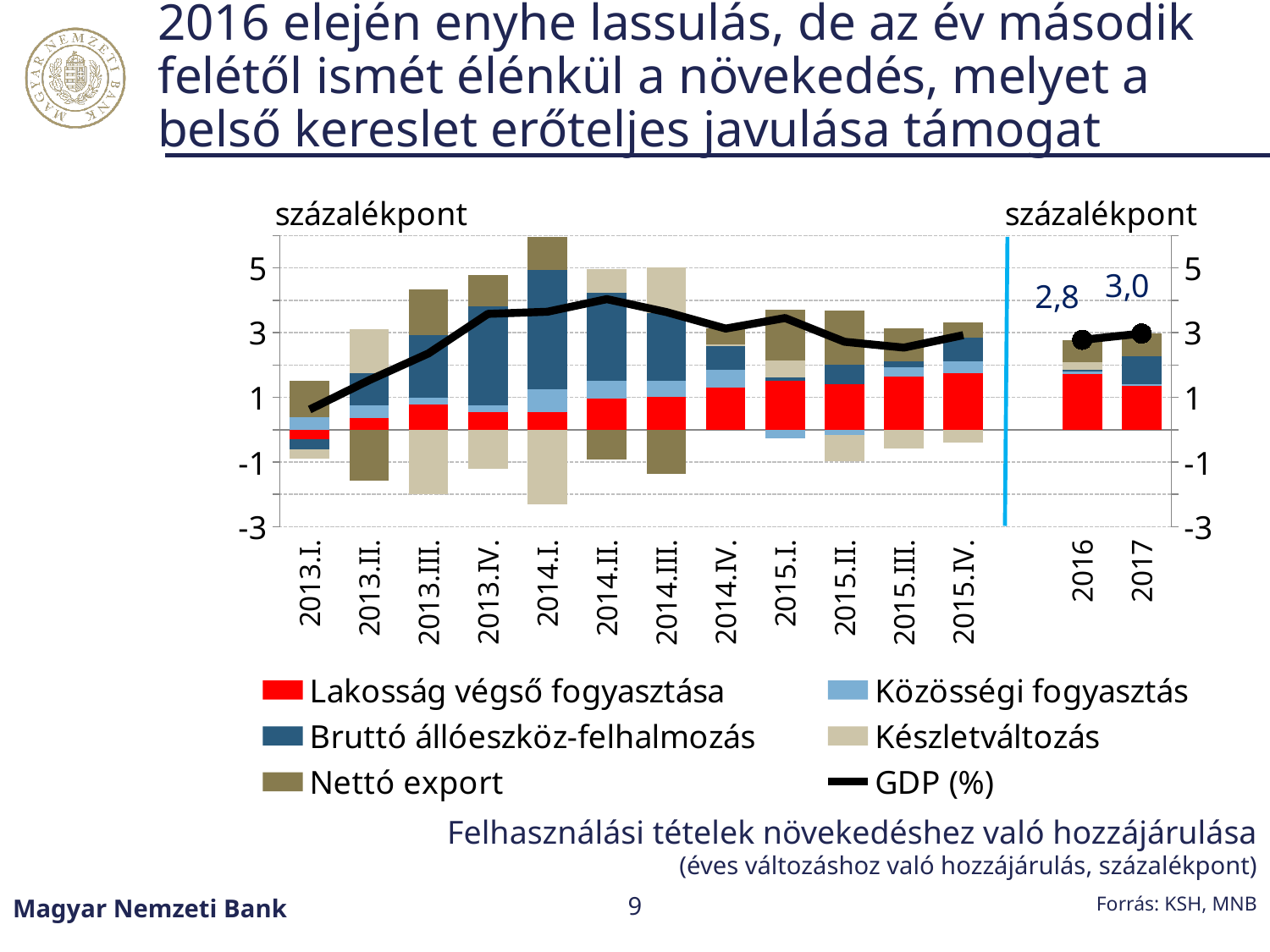
How many categories are shown on the x axis? 14 Is the GDP (%) value for 2014.II. greater or less than 3? greater What is the title of the chart? Felhasználási tételek növekedéshez való hozzájárulása What is the difference between the GDP (%) values for 2017 and 2016? 0,2 How many series does the legend list? 6 Which year has the higher GDP (%) value, 2016 or 2017? 2017 What is the GDP (%) value shown for 2017? 3,0 Is the GDP (%) value for 2013.I. greater or less than 1? less In which quarter does the GDP (%) line reach its lowest point? 2013.I. What is the GDP (%) value shown for 2016? 2,8 What kind of chart is this? combination bar and line chart Does the GDP (%) line rise or fall from 2016 to 2017? rise